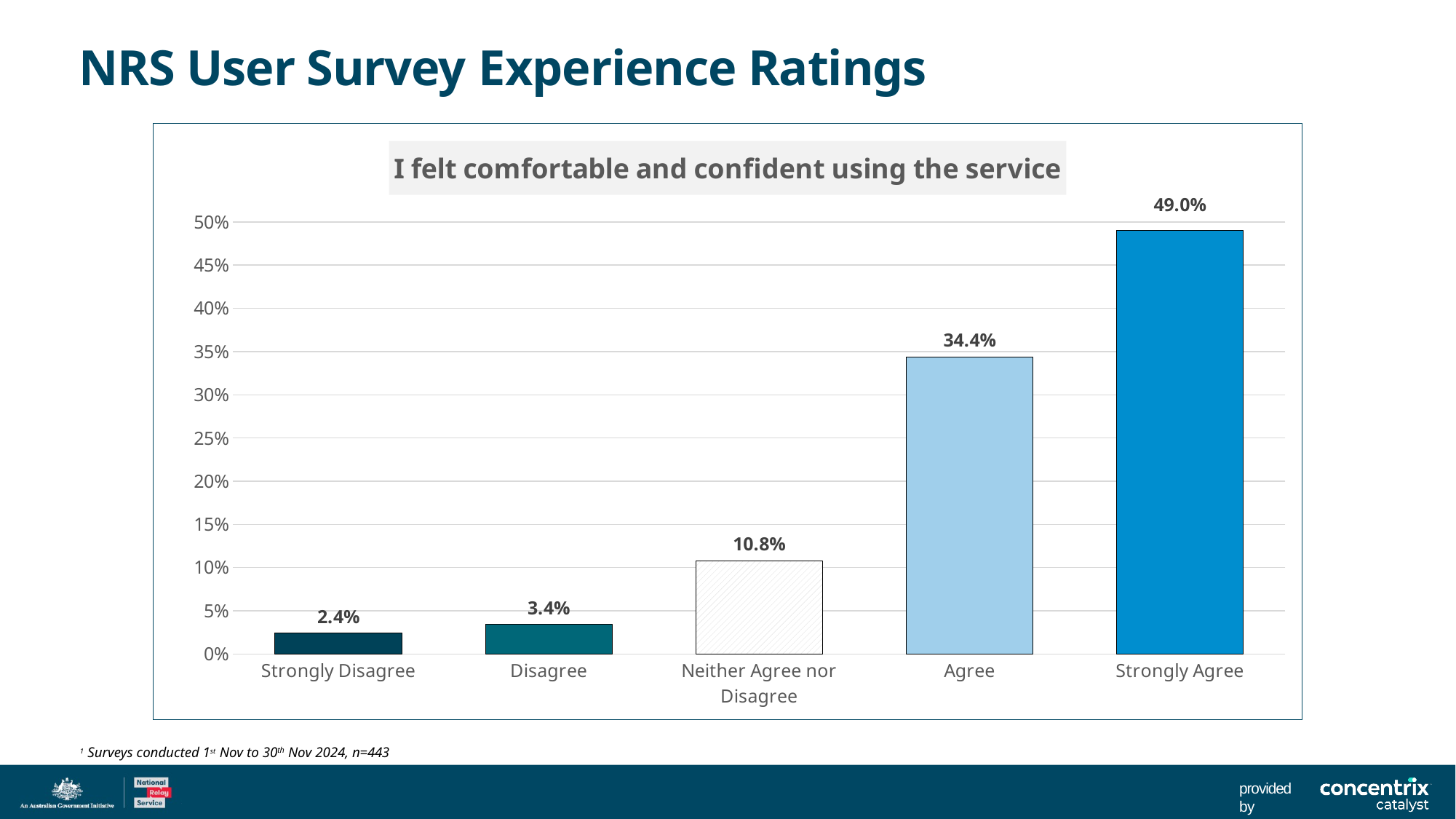
What kind of chart is shown on the slide? Bar chart What is the difference between the Strongly Agree and Agree values? 14.6% What percentage of respondents answered Strongly Agree? 49.0% What is the value for Neither Agree nor Disagree? 10.8% Which response category has the lowest value? Strongly Disagree Which is larger, the value for Agree or the value for Neither Agree nor Disagree? Agree What percentage of respondents answered Disagree? 3.4% What is the title of the chart? I felt comfortable and confident using the service How many response categories are shown on the x axis? 5 What is the difference between the Disagree and Strongly Disagree values? 1.0% Is the value for Agree greater or less than 30%? greater Which response category has the highest value? Strongly Agree